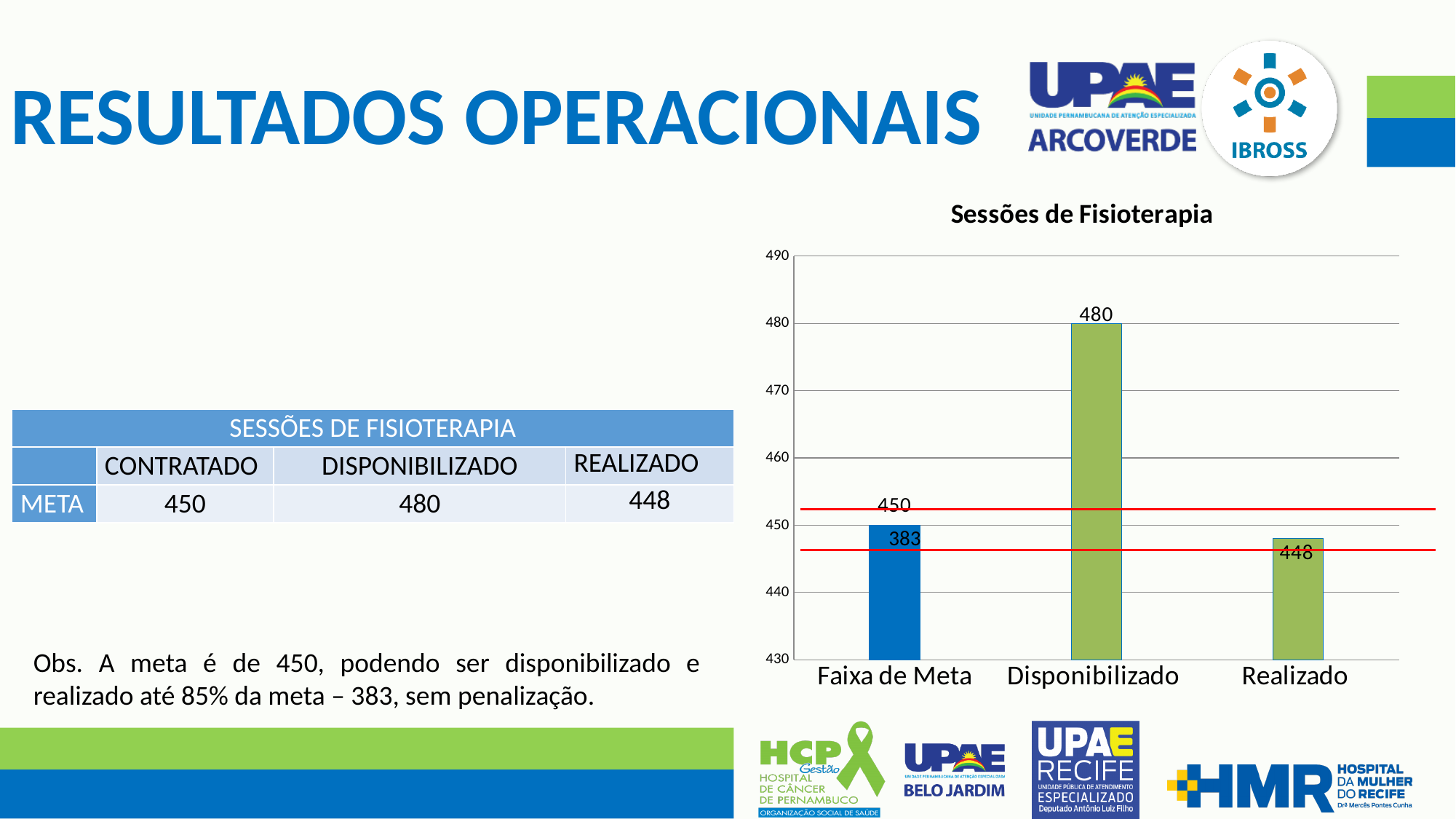
What is the value labelled for Realizado in the chart? 448 Is the value for Disponibilizado greater or less than 470? greater How many categories are shown on the x axis of the chart? 3 What is the title of the chart? Sessões de Fisioterapia What is the value labelled for Disponibilizado in the chart? 480 What type of chart is shown on the slide? bar chart Which is larger, the value for Disponibilizado or the value for Realizado? Disponibilizado Which category has the highest bar in the chart? Disponibilizado Is the value for Realizado greater or less than 450? less What is the difference between the Disponibilizado value and the Realizado value? 32 Which category has the lowest bar in the chart? Realizado What is the highest value shown on the y axis of the chart? 490